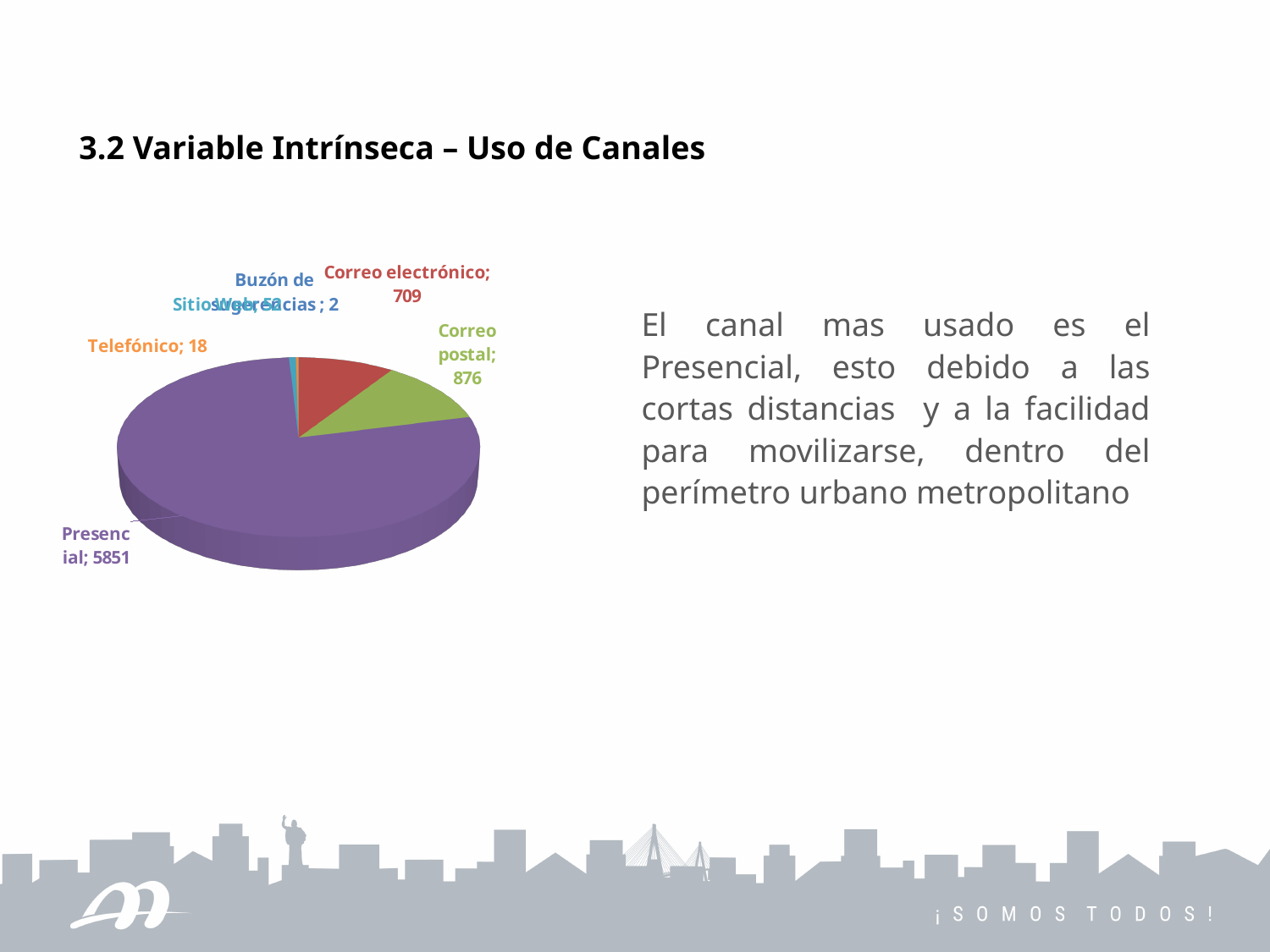
Which is larger, Presencial or Correo electrónico? Presencial What is the value for Correo postal in the pie chart? 876 What kind of chart is shown on the slide? pie chart What is the value for Presencial in the pie chart? 5851 What colour is the Presencial slice in the pie chart? purple Which is larger, Correo postal or Correo electrónico? Correo postal What is the value for Telefónico in the pie chart? 18 What is the difference between the values for Correo postal and Correo electrónico? 167 Which channel has the largest slice in the pie chart? Presencial What is the value for Correo electrónico in the pie chart? 709 What is the difference between the values for Presencial and Correo postal? 4975 What colour is the Correo electrónico slice in the pie chart? red